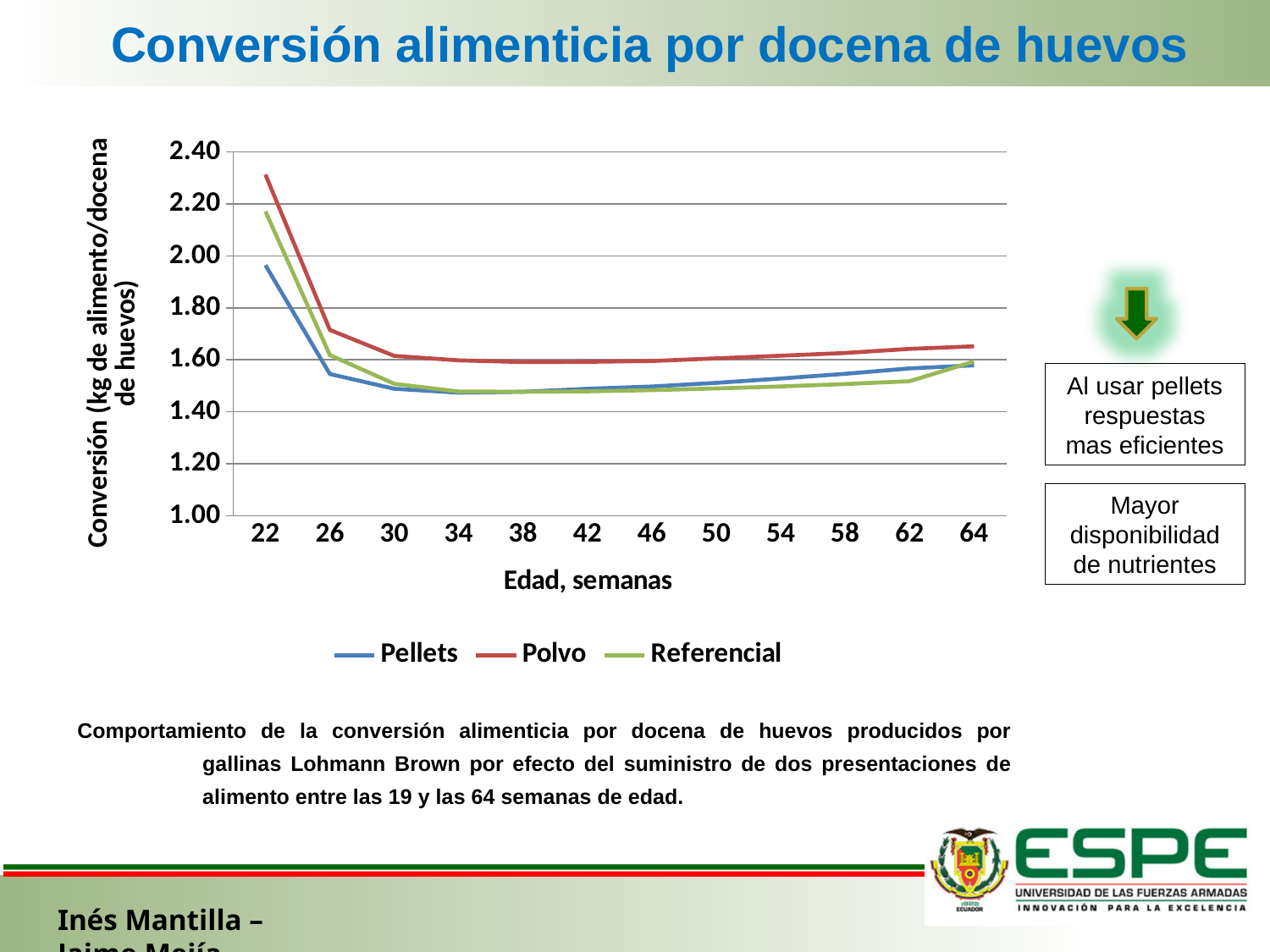
What kind of chart is shown on the slide? line chart How many series does the legend list? 3 What is the title of the x axis? Edad, semanas Which series has the lowest value at 22 weeks? Pellets Which series has the highest value at 22 weeks? Polvo At 22 weeks, which is larger, the value for Polvo or the value for Pellets? Polvo Which series is drawn in red? Polvo Is the value for Polvo at 22 weeks greater or less than 2.20? greater Is the value for Referencial at 22 weeks greater or less than 2.00? greater Is the value for Pellets at 38 weeks greater or less than 1.60? less How many age points are shown along the x axis? 12 Does the Polvo line rise or fall between 22 and 34 weeks? fall